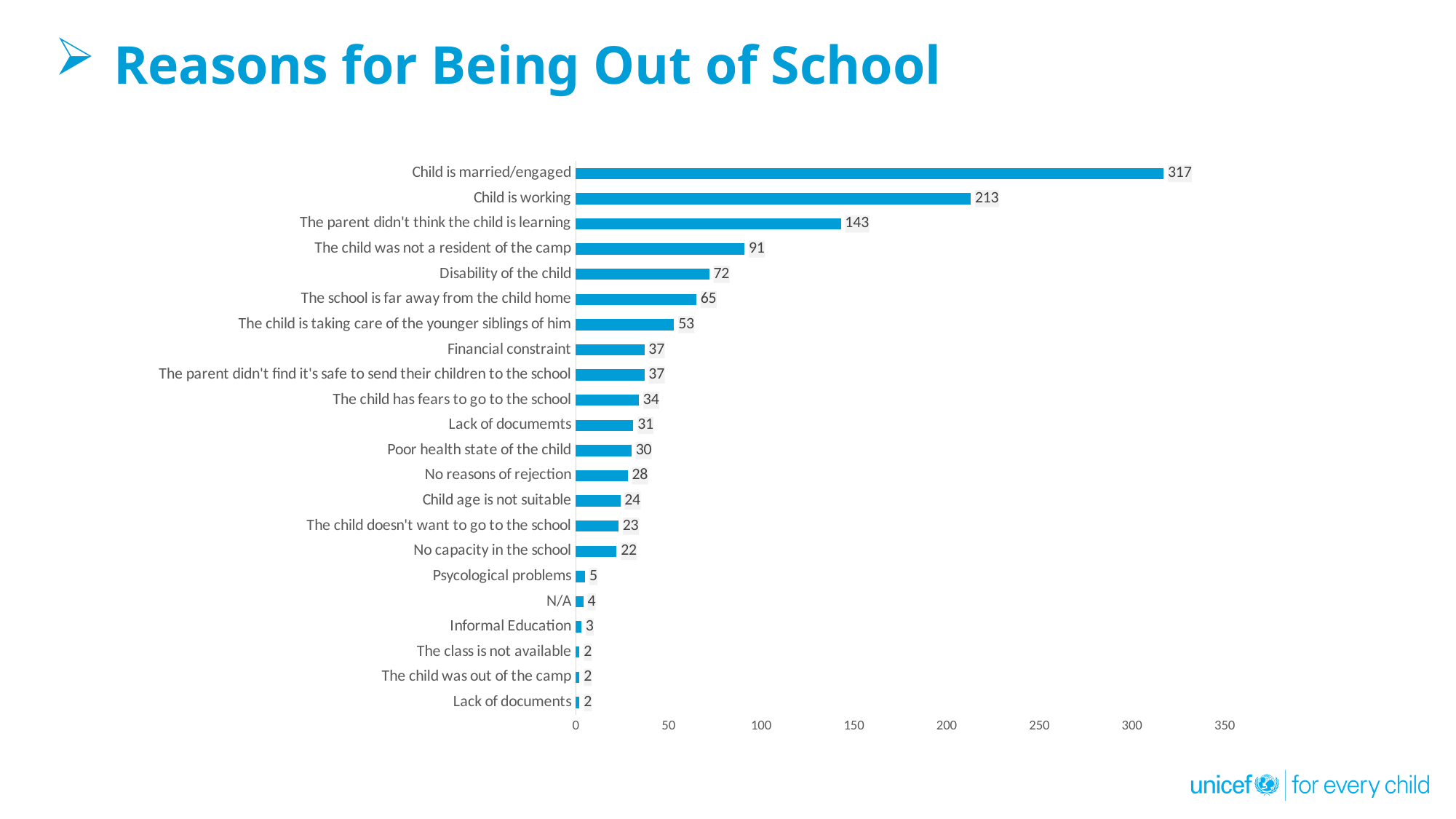
What is the difference between the values for "Child is married/engaged" and "Child is working"? 104 What is the value for "Child is working"? 213 What kind of chart is shown on the slide? Bar chart What is the value for "Disability of the child"? 72 Is the value for "The parent didn't think the child is learning" greater or less than 100? greater What is the value for "Psycological problems"? 5 What is the value for "Financial constraint"? 37 What is the difference between the values for "The child was not a resident of the camp" and "Disability of the child"? 19 Which is larger, the value for "The school is far away from the child home" or the value for "The child is taking care of the younger siblings of him"? The school is far away from the child home Which reason has the highest value? Child is married/engaged How many reasons (categories) are shown in the chart? 22 What is the value for "Child is married/engaged"? 317